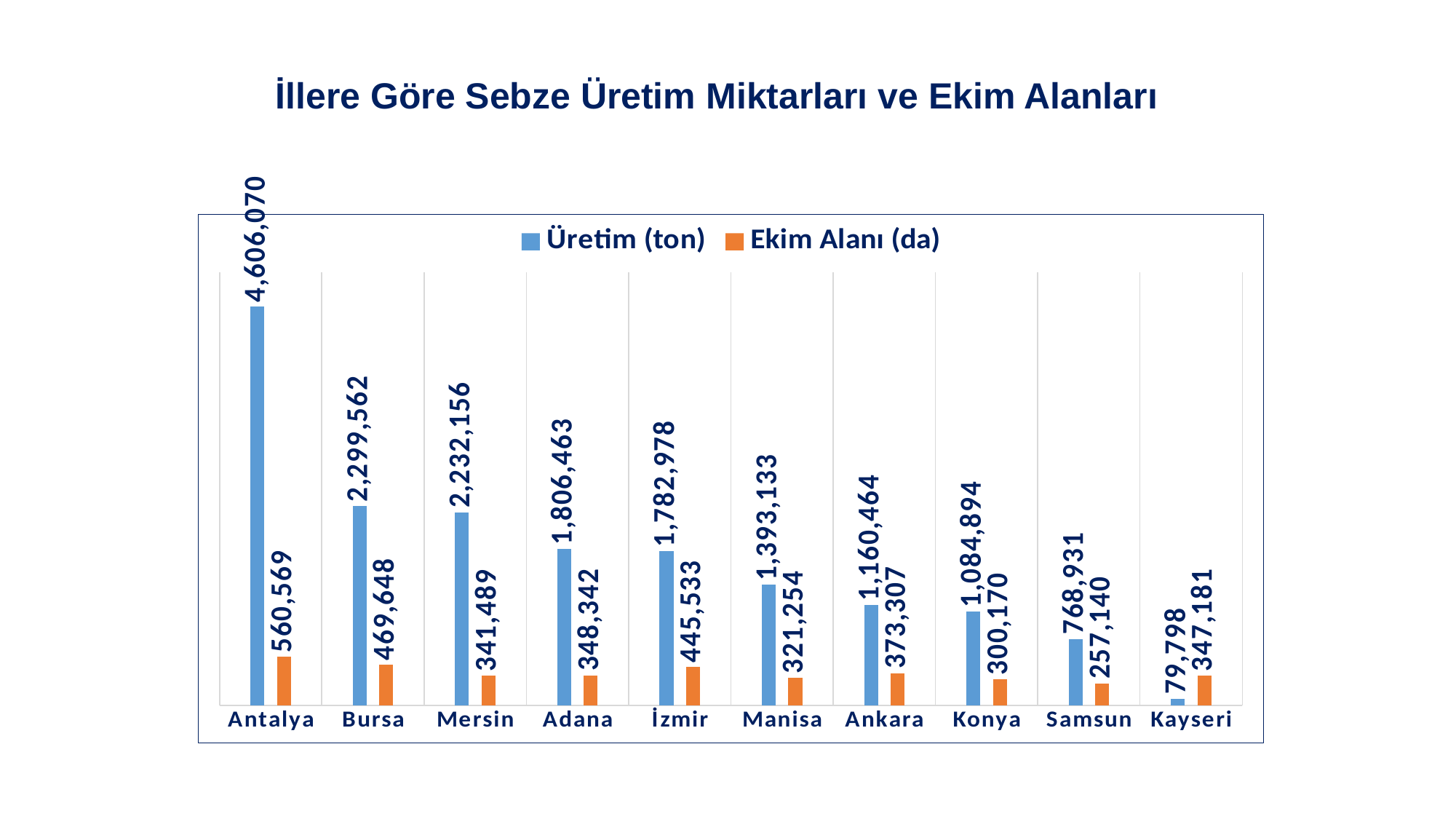
What is the Üretim (ton) value for Mersin? 2,232,156 Which is larger, the Ekim Alanı (da) value for Ankara or for Manisa? Ankara Which province has the lowest Ekim Alanı (da) value? Samsun What is the Ekim Alanı (da) value for İzmir? 445,533 What kind of chart is shown on the slide? Bar chart What is the difference between the Üretim (ton) values for Antalya and Bursa? 2,306,508 What is the difference between the Ekim Alanı (da) values for Antalya and Bursa? 90,921 What is the Üretim (ton) value for Kayseri? 79,798 Which province has the lowest Üretim (ton) value? Kayseri How many provinces are shown on the x axis? 10 Which province has the highest Üretim (ton) value? Antalya How many series does the legend list? 2